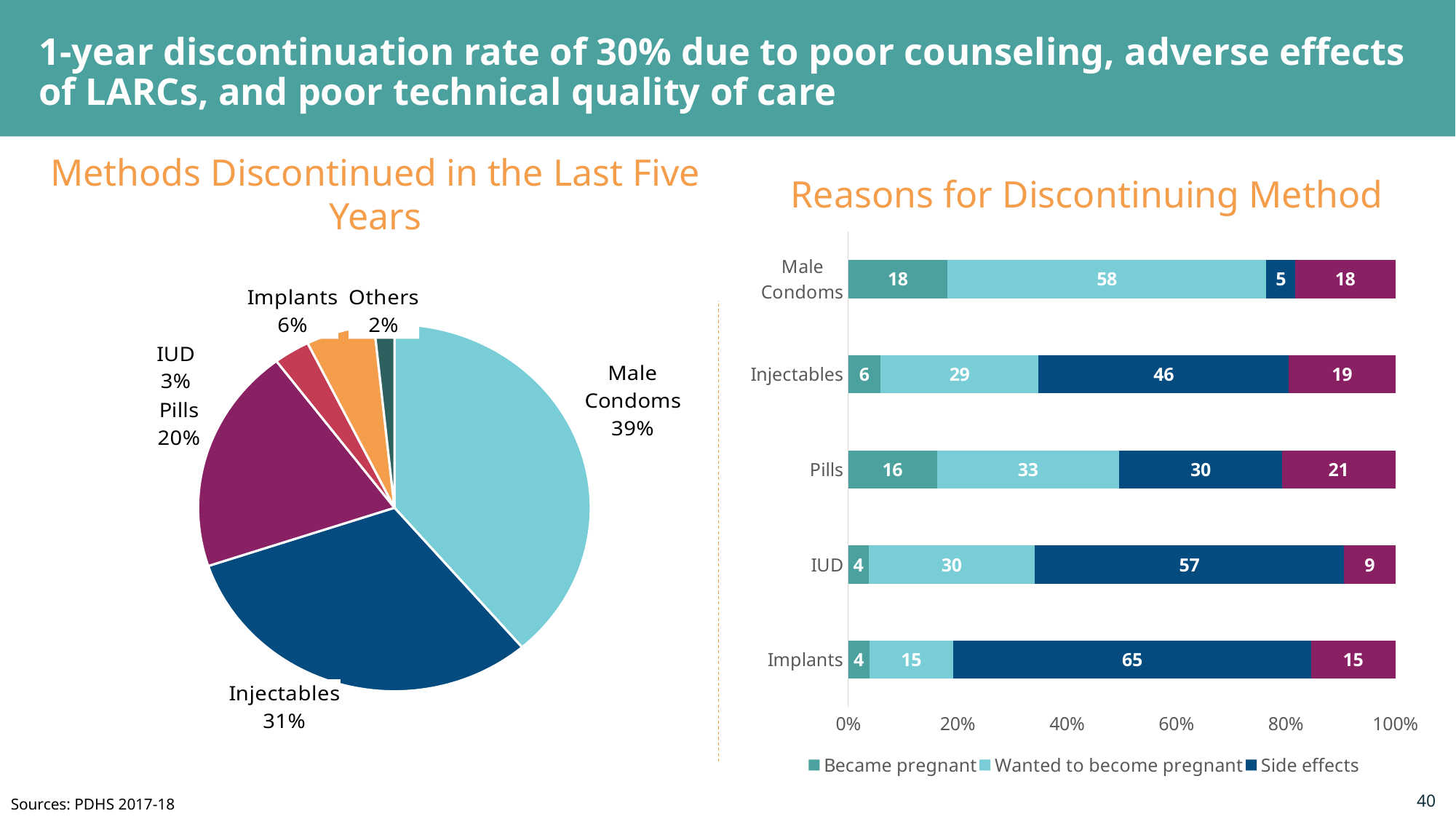
In the 'Methods Discontinued in the Last Five Years' chart, what share of the pie is Male Condoms? 39% What kind of chart is 'Methods Discontinued in the Last Five Years'? Pie chart What kind of chart is 'Reasons for Discontinuing Method'? Stacked bar chart In the 'Methods Discontinued in the Last Five Years' chart, which method has the largest slice? Male Condoms In the 'Reasons for Discontinuing Method' chart, which method has the highest Side effects value? Implants How many series does the legend of the 'Reasons for Discontinuing Method' chart list? 3 In the 'Reasons for Discontinuing Method' chart, is the 'Became pregnant' value larger for Male Condoms or for Injectables? Male Condoms In the 'Methods Discontinued in the Last Five Years' chart, which category has the smallest slice? Others In the 'Reasons for Discontinuing Method' chart, what is the 'Wanted to become pregnant' value for Male Condoms? 58 In the 'Reasons for Discontinuing Method' chart, what is the Side effects value for Implants? 65 In the 'Methods Discontinued in the Last Five Years' chart, what is the difference in percentage points between Injectables and Pills? 11 How many slices does the 'Methods Discontinued in the Last Five Years' pie chart have? 6